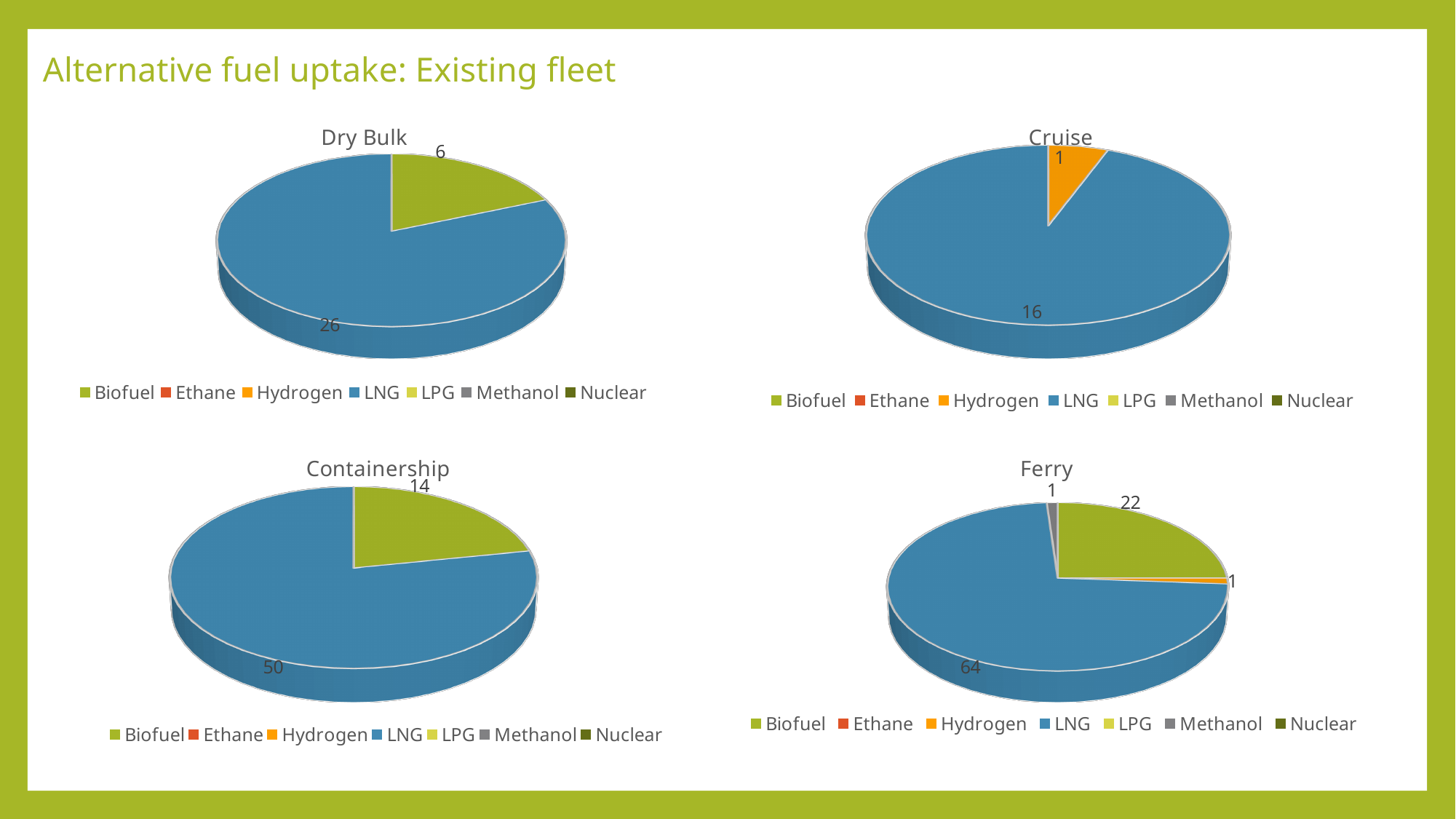
In the Ferry chart, what is the value for Biofuel? 22 In the Cruise chart, which is larger, LNG or Hydrogen? LNG In the Ferry chart, what is the total of all slices? 88 In the Ferry chart, which fuel has the largest slice? LNG In the Containership chart, what is the value for LNG? 50 In the Dry Bulk chart, what is the value for LNG? 26 How many entries does the legend of the Ferry chart list? 7 In the Dry Bulk chart, what is the total of all slices? 32 What kind of chart is the Containership chart? Pie chart In the Cruise chart, what is the value for Hydrogen? 1 In the Containership chart, what is the difference between the LNG and Biofuel values? 36 In the Dry Bulk chart, what is the value for Biofuel? 6